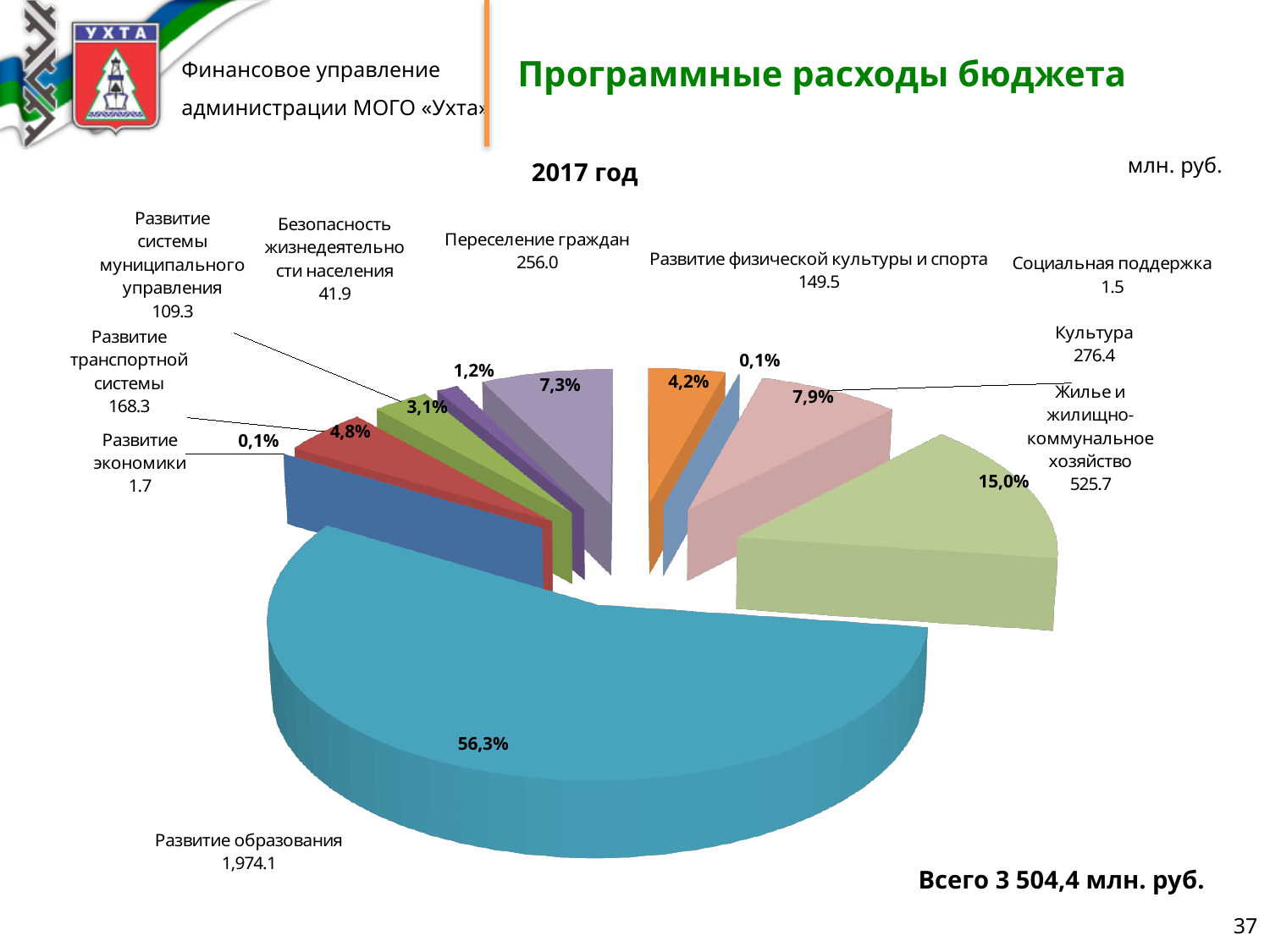
What is the difference between Переселение граждан and Развитие физической культуры и спорта? 106.5 What share of the pie does Развитие образования take? 56,3% What type of chart is shown on the slide? Pie chart What share of the pie does Жилье и жилищно-коммунальное хозяйство take? 15,0% What is the value for Жилье и жилищно-коммунальное хозяйство? 525.7 What is the value for Развитие транспортной системы? 168.3 Which is larger, Культура or Переселение граждан? Культура Which category has the smallest value? Социальная поддержка What is the value for Культура? 276.4 Which category has the largest value? Развитие образования How many categories does the pie chart have? 10 What is the value for Развитие образования? 1,974.1